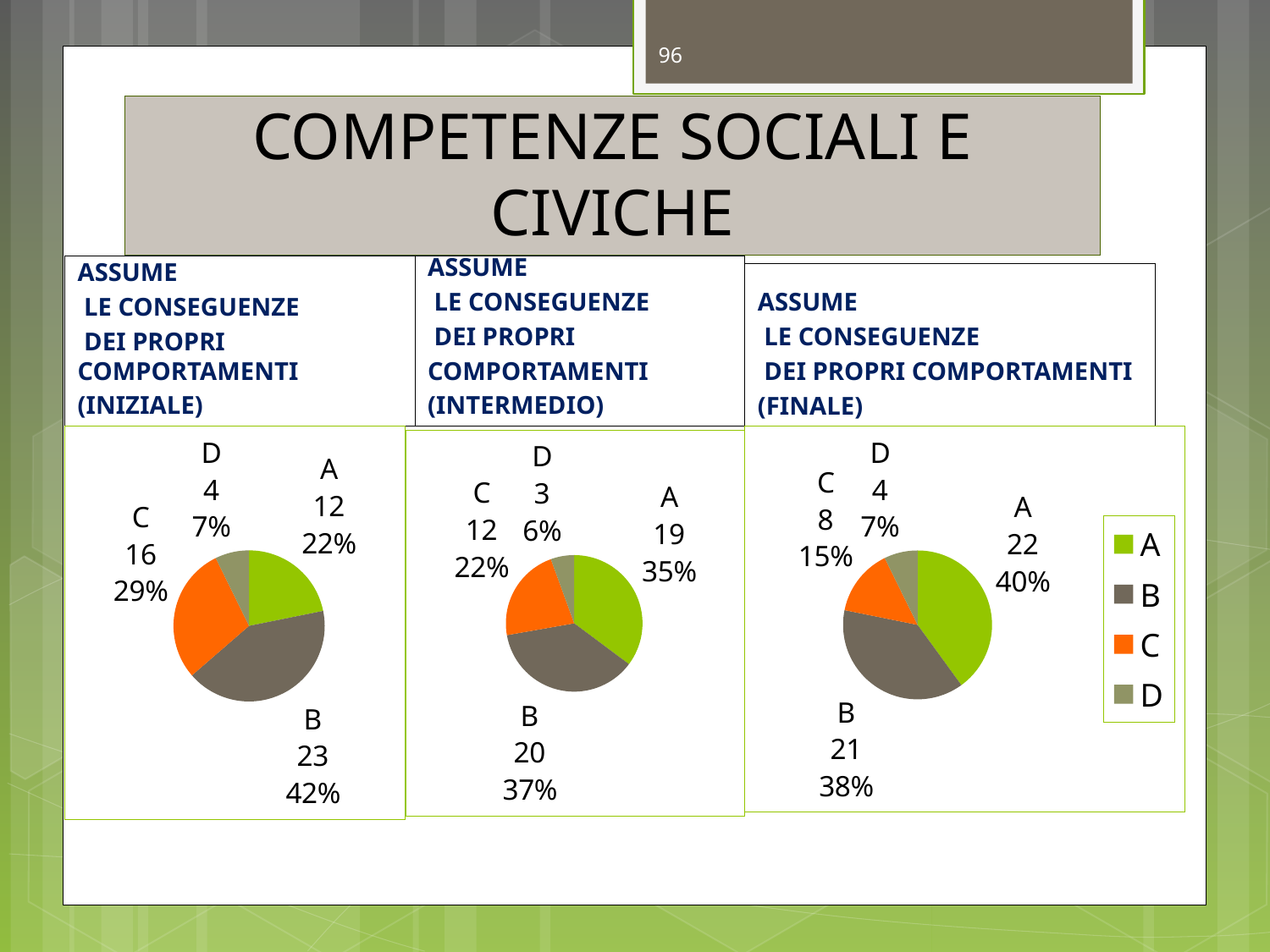
In the FINALE pie chart, what is the difference between the counts for A and D? 18 In the INTERMEDIO pie chart, what is the count for category A? 19 In the INIZIALE pie chart, which category has the smallest share? D In the INTERMEDIO pie chart, what percentage share does category D have? 6% In the INIZIALE pie chart, what is the count for category B? 23 In the INIZIALE pie chart, what percentage share does category C have? 29% How many categories does the legend on the right list? 4 In the INTERMEDIO pie chart, what is the difference between the counts for B and C? 8 In the FINALE pie chart, what percentage share does category B have? 38% What type of chart is used on this slide? Pie chart In the FINALE pie chart, what is the count for category C? 8 In the FINALE pie chart, which category has the largest share? A